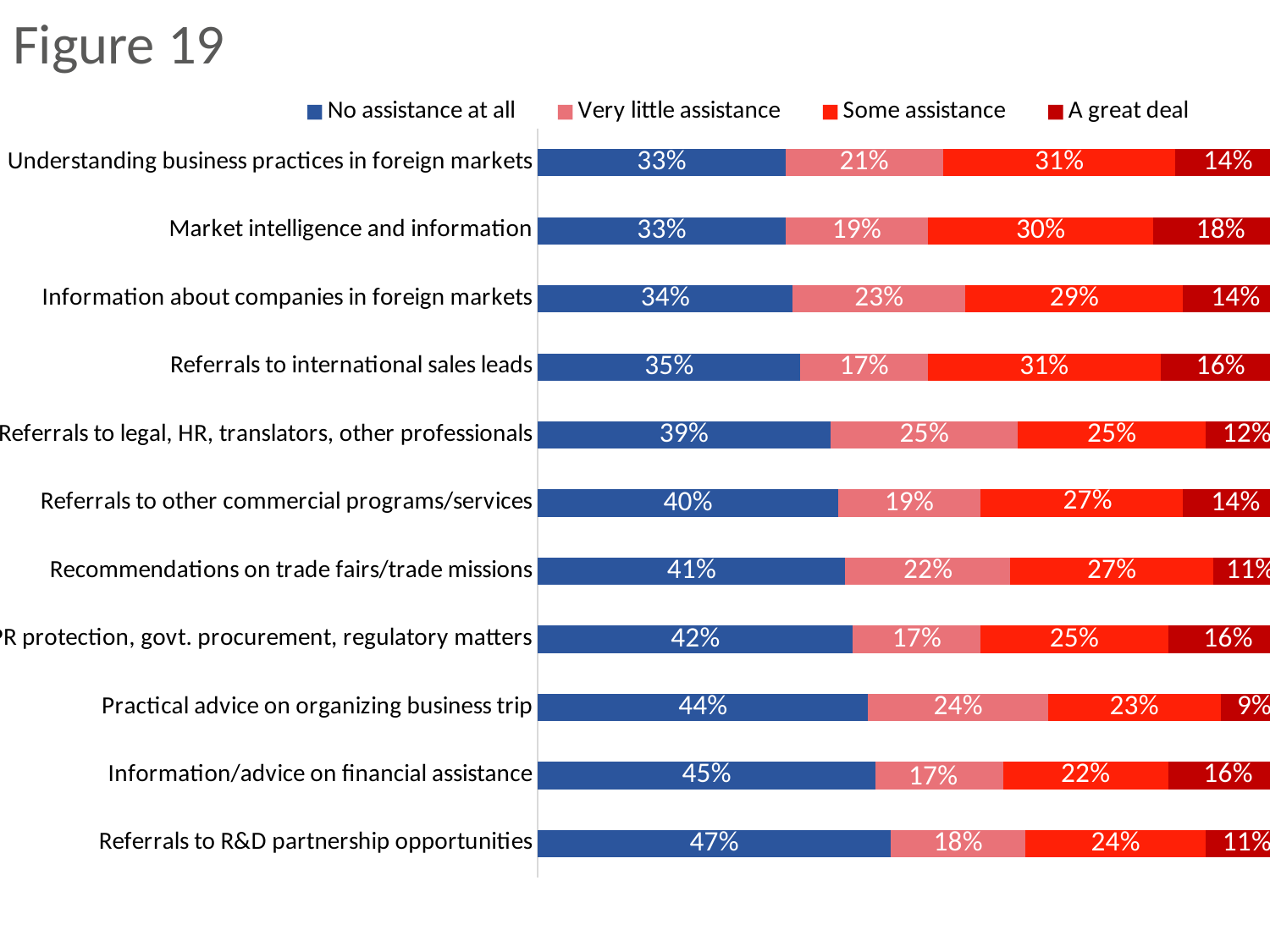
Which legend entry is shown in dark red? A great deal What is the 'Some assistance' value for 'Market intelligence and information'? 30% What type of chart is shown on the slide? Stacked bar chart What is the 'No assistance at all' value for 'Referrals to R&D partnership opportunities'? 47% How many series does the legend list? 4 Which category has the highest 'No assistance at all' value? Referrals to R&D partnership opportunities What is the difference between the 'No assistance at all' values for 'Information/advice on financial assistance' and 'Understanding business practices in foreign markets'? 12% Which is larger: the 'Very little assistance' value for 'Referrals to legal, HR, translators, other professionals' or for 'Referrals to international sales leads'? Referrals to legal, HR, translators, other professionals Which category has the lowest 'A great deal' value? Practical advice on organizing business trip What is the total of the stacked bar for 'Market intelligence and information'? 100% What is the 'A great deal' value for 'Practical advice on organizing business trip'? 9% How many categories are plotted in the chart? 11